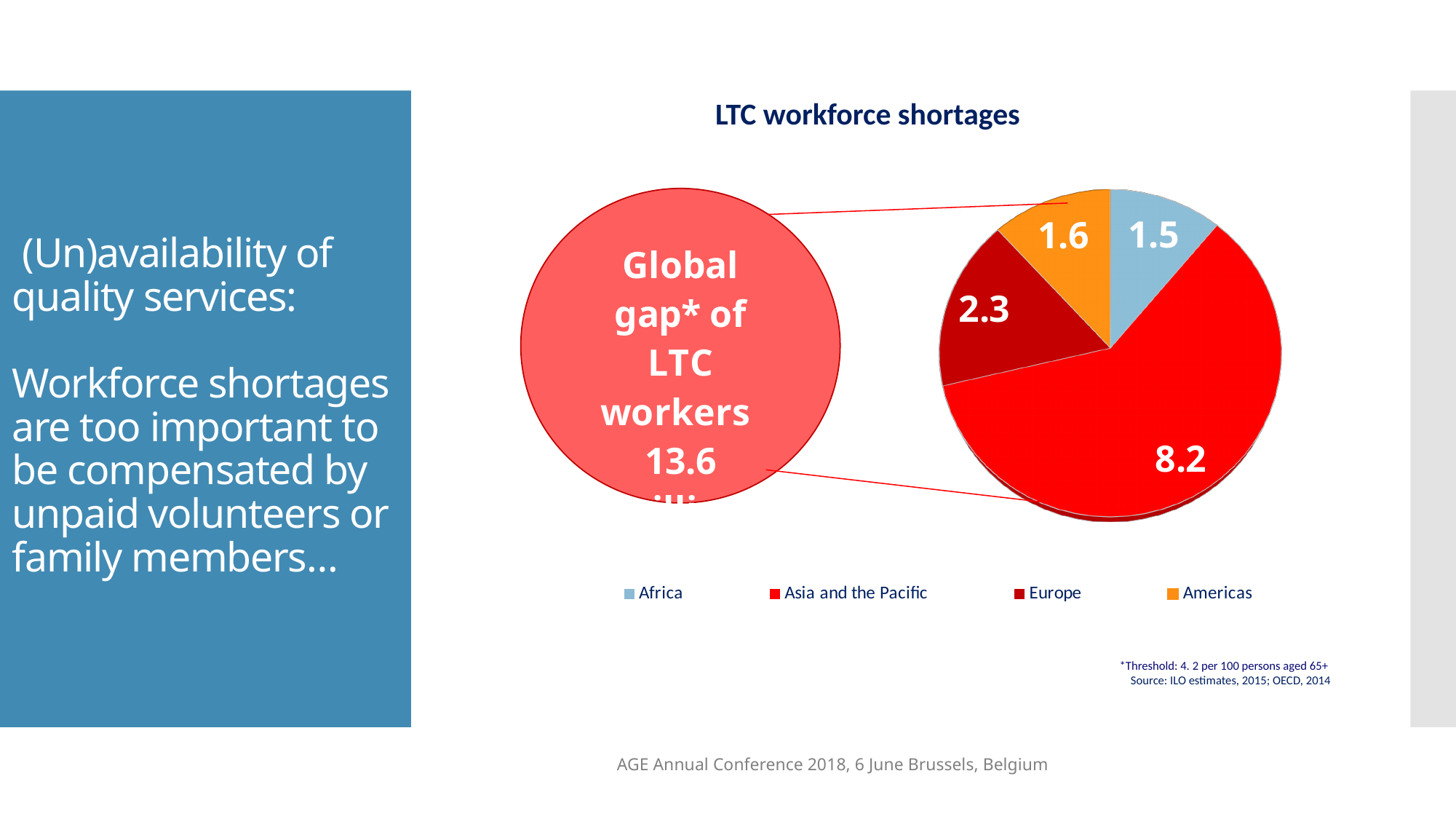
How many regions are shown in the pie chart? 4 What kind of chart is shown on the slide? pie chart What is the title of the chart? LTC workforce shortages What is the total of all the slices in the pie chart? 13.6 What is the difference between the values for Asia and the Pacific and Europe? 5.9 What is the value for Europe? 2.3 Which region has the largest slice of the pie? Asia and the Pacific What is the value for Asia and the Pacific? 8.2 Which is larger, the value for Europe or the value for the Americas? Europe What is the value for the Americas? 1.6 What is the value for Africa? 1.5 Which region has the smallest slice of the pie? Africa